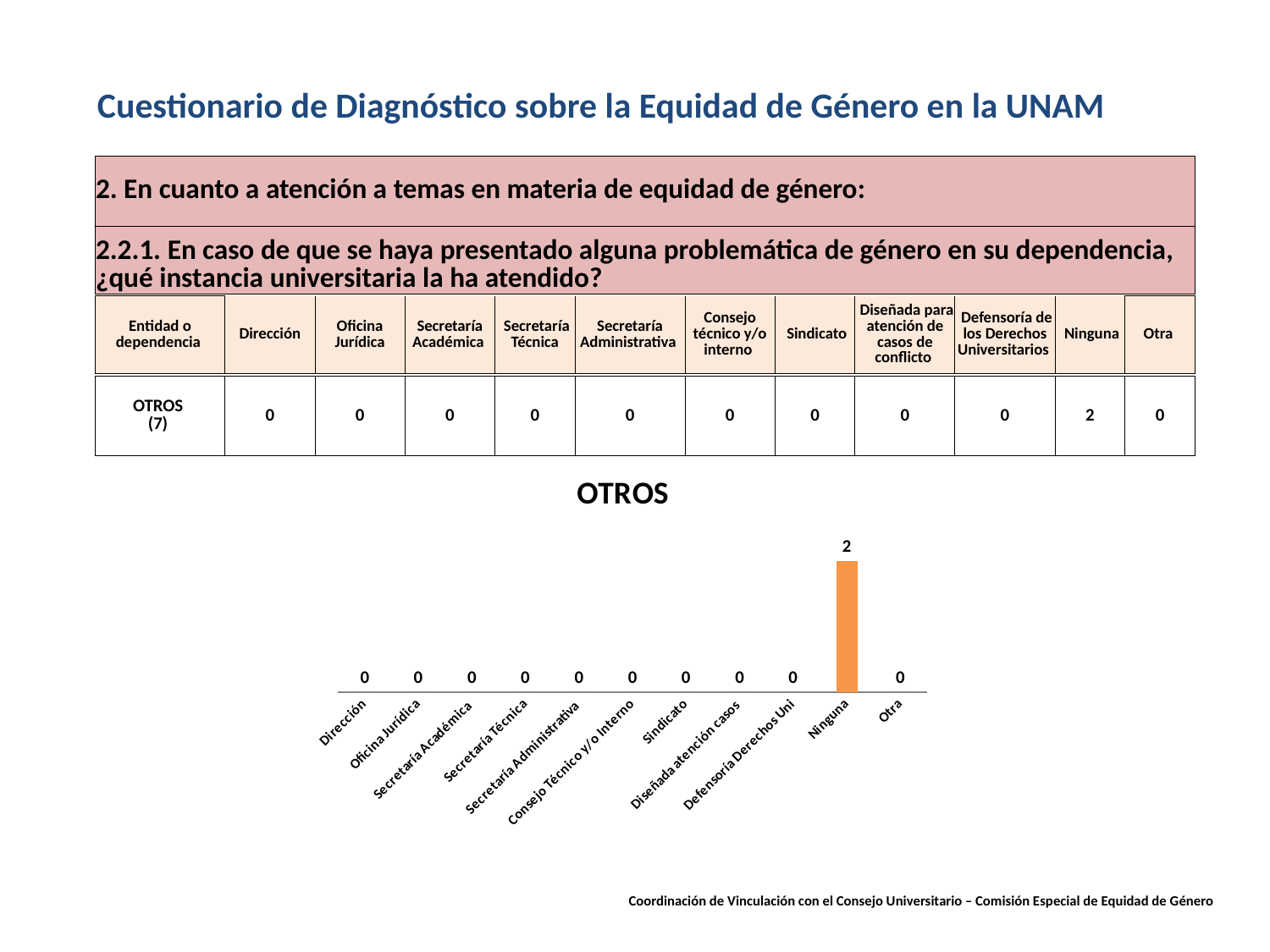
What is the value for Dirección in the OTROS chart? 0 What is the value for Ninguna in the OTROS chart? 2 What is the value for Sindicato in the OTROS chart? 0 How many categories are shown on the x axis of the OTROS chart? 11 What is the title of the chart on the slide? OTROS What is the difference between the values for Ninguna and Otra in the OTROS chart? 2 What is the value for Otra in the OTROS chart? 0 What kind of chart is shown on the slide? Bar chart How many categories in the OTROS chart have a value of 0? 10 What is the value for Secretaría Académica in the OTROS chart? 0 Which category has the highest value in the OTROS chart? Ninguna Which is larger in the OTROS chart, the value for Ninguna or the value for Sindicato? Ninguna